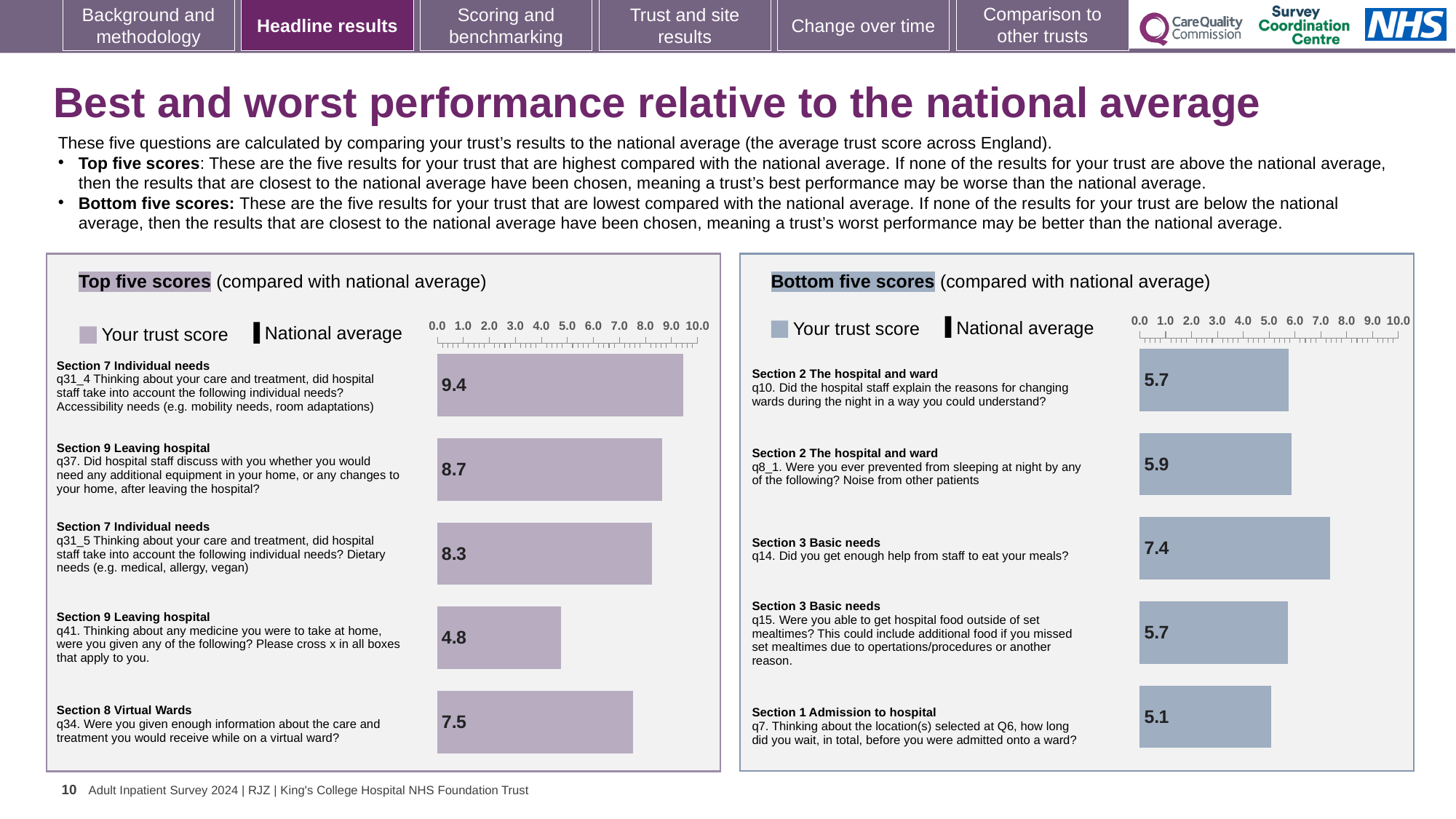
How many questions are plotted in the Bottom five scores chart? 5 In the Bottom five scores chart, what is the trust score for q7 about how long you waited before being admitted onto a ward? 5.1 In the Top five scores chart, what is the trust score for q37 (Did hospital staff discuss with you whether you would need any additional equipment in your home)? 8.7 In the Top five scores chart, what is the trust score for q34 about information on care and treatment while on a virtual ward? 7.5 How many series does the legend of the Top five scores chart list? 2 In the Bottom five scores chart, which has the larger trust score: q8_1 (Noise from other patients) or q15 (hospital food outside of set mealtimes)? q8_1 (5.9) In the Top five scores chart, what is the difference between the trust scores for q31_4 (Accessibility needs) and q31_5 (Dietary needs)? 1.1 In the Bottom five scores chart, what is the trust score for q14 (Did you get enough help from staff to eat your meals)? 7.4 In the Bottom five scores chart, which question has the lowest trust score? q7 wait before admitted onto a ward (5.1) In the Top five scores chart, which question has the lowest trust score? q41 medicine to take at home (4.8) In the Top five scores chart, which question has the highest trust score? q31_4 Accessibility needs (9.4) What kind of chart is used in the Top five scores panel? Bar chart